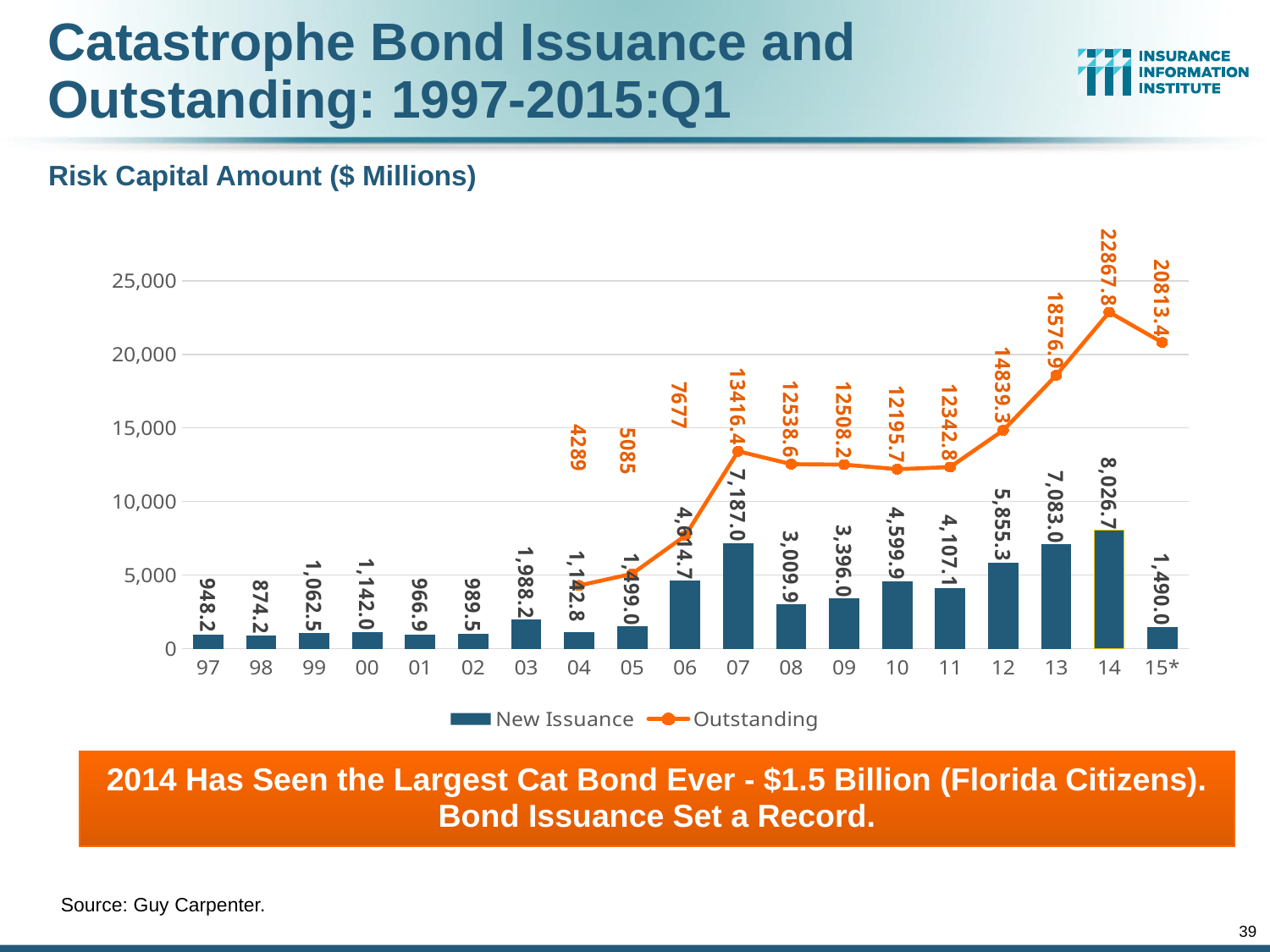
What is the difference between New Issuance in 14 and in 13? 943.7 How many series does the legend list? 2 Which is larger, the Outstanding value in 07 or in 12? 12 Does the Outstanding line rise or fall from 11 to 14? Rise How many years are shown on the x axis? 19 What is the Outstanding value for 2014 (14)? 22867.8 What is the New Issuance value for 15*? 1,490.0 Which year has the lowest New Issuance? 98 Is the Outstanding value for 13 greater or less than 15,000? greater What kind of chart is this? Combined bar and line chart What is the New Issuance value for 2014 (14)? 8,026.7 Which year has the highest New Issuance? 14